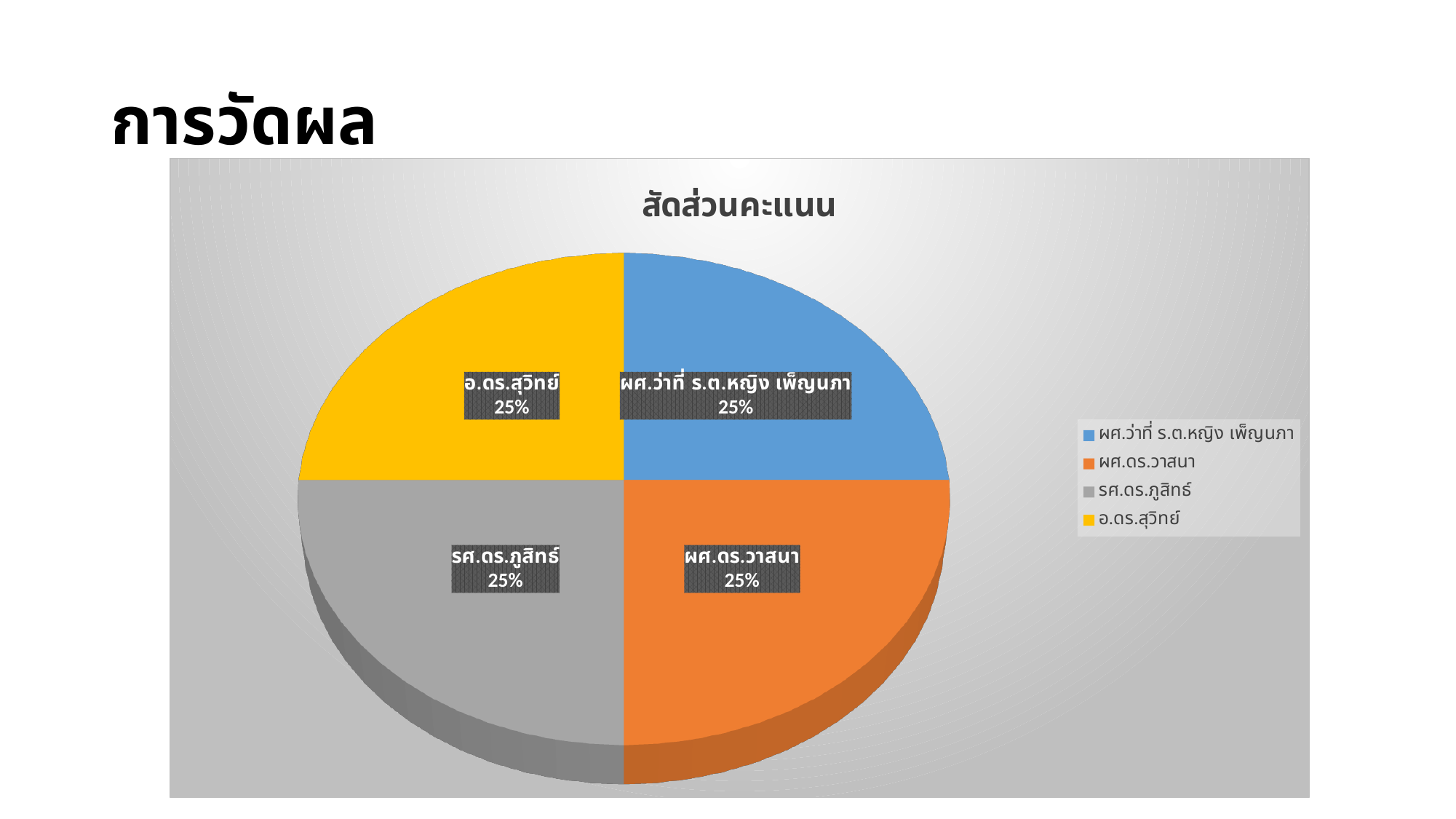
What is the combined share of ผศ.ว่าที่ ร.ต.หญิง เพ็ญนภา and ผศ.ดร.วาสนา? 50% What is the title of the chart? สัดส่วนคะแนน What is the value shown for รศ.ดร.ภูสิทธิ์? 25% Is the share for รศ.ดร.ภูสิทธิ์ greater or less than 50%? less How many slices does the pie chart have? 4 What is the value shown for ผศ.ดร.วาสนา? 25% How many entries does the legend list? 4 What type of chart is shown on the slide? Pie chart What is the difference between the shares of อ.ดร.สุวิทย์ and ผศ.ดร.วาสนา? 0% What share of the pie does ผศ.ว่าที่ ร.ต.หญิง เพ็ญนภา have? 25% Which colour represents อ.ดร.สุวิทย์ in the pie chart? Yellow What share of the pie does อ.ดร.สุวิทย์ have? 25%